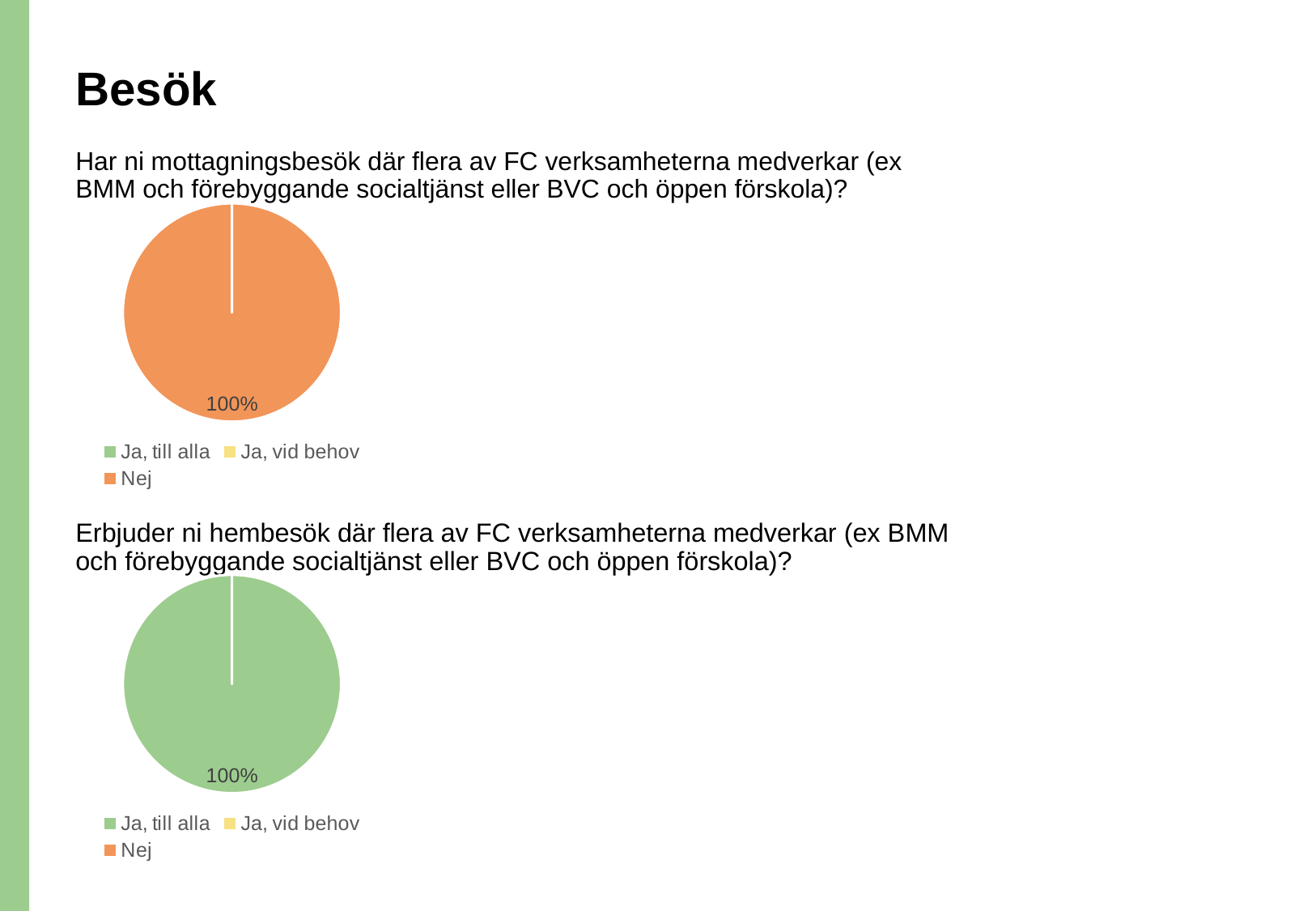
In the top pie chart (mottagningsbesök), which category makes up the whole pie? Nej In the top pie chart (mottagningsbesök), is the share for "Nej" larger or smaller than the share for "Ja, till alla"? larger In the bottom pie chart (hembesök), which category makes up the whole pie? Ja, till alla In the top pie chart (mottagningsbesök), what share does the "Nej" slice have? 100% What kind of chart is used for the question "Har ni mottagningsbesök där flera av FC verksamheterna medverkar"? Pie chart What colour is the single slice in the bottom pie chart (hembesök)? Green What colour is the single slice in the top pie chart (mottagningsbesök)? Orange How many entries does the legend of the bottom pie chart (hembesök) list? 3 How many entries does the legend of the top pie chart (mottagningsbesök) list? 3 How many pie charts are shown on the slide? 2 In the bottom pie chart (hembesök), is the share for "Ja, till alla" larger or smaller than the share for "Nej"? larger In the bottom pie chart (hembesök), what share does the "Ja, till alla" slice have? 100%